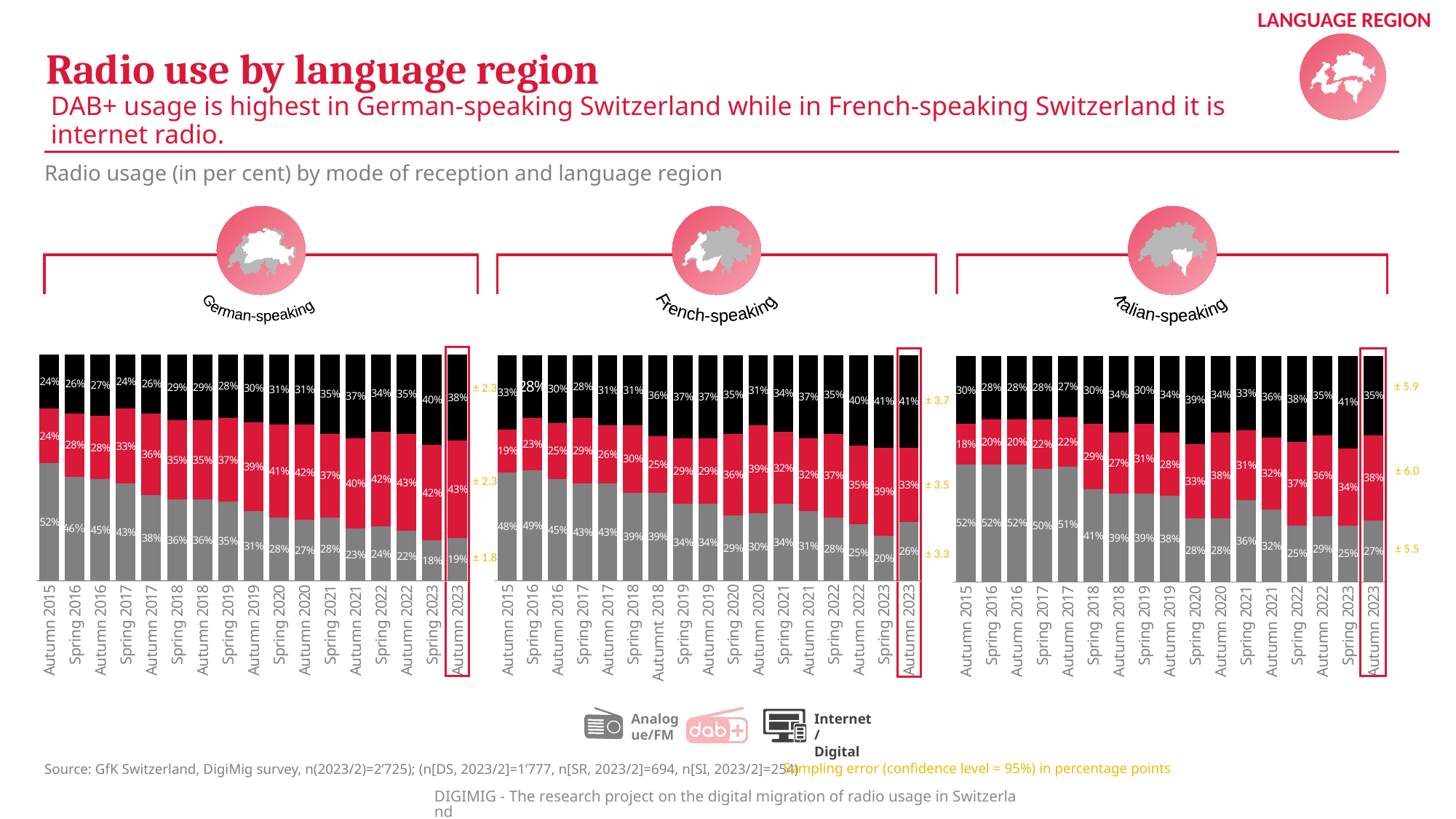
What type of chart is used for each language region? Stacked bar chart In the German-speaking chart, what is the DAB+ share in Autumn 2023? 43% In the Italian-speaking chart, what is the DAB+ share in Autumn 2023? 38% In the German-speaking chart, what is the difference between the Analogue/FM share in Autumn 2015 and in Autumn 2023? 33 percentage points In the French-speaking chart, which is larger in Autumn 2023: the DAB+ share or the Internet/Digital share? Internet/Digital In the Italian-speaking chart, does the Analogue/FM share rise or fall from Autumn 2015 to Autumn 2023? Fall In the German-speaking chart, what is the Analogue/FM share in Autumn 2023? 19% In the German-speaking chart, which period has the lowest Analogue/FM share? Spring 2023 In the Italian-speaking chart, what is the Analogue/FM share in Autumn 2015? 52% In the French-speaking chart, what is the Internet/Digital share in Autumn 2023? 41% How many modes of reception does the legend list? 3 How many time periods are shown on the x axis of the German-speaking chart? 17